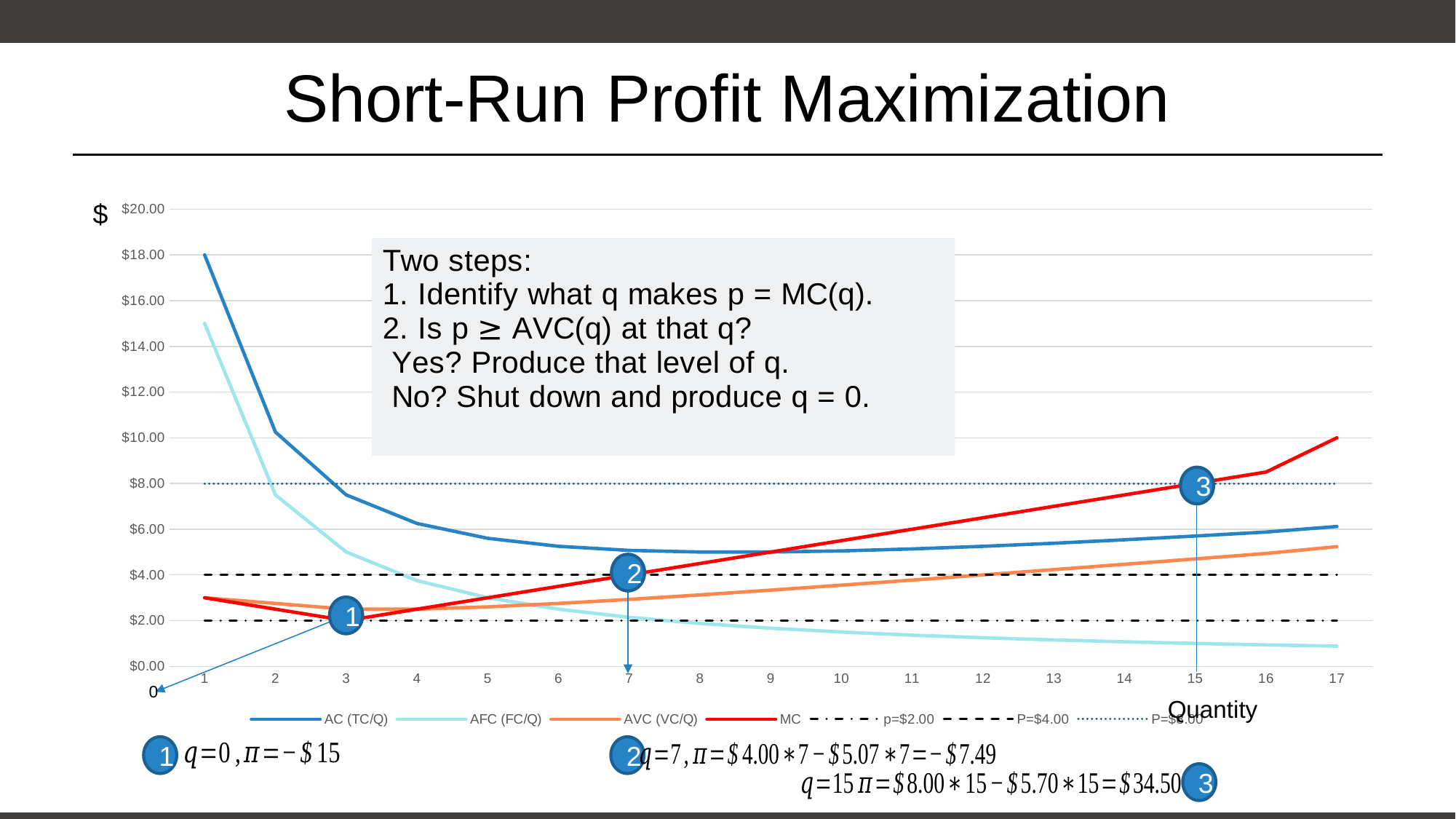
At quantity 17, which is higher: AC (TC/Q) or AVC (VC/Q)? AC (TC/Q) Which series has the highest value at quantity 1? AC (TC/Q) How many series does the chart legend list? 7 Is the value of AFC (FC/Q) at quantity 17 greater or less than $2.00? less Which series has the lowest value at quantity 17? AFC (FC/Q) Is the value of AC (TC/Q) at quantity 1 greater or less than $16.00? greater What kind of chart is shown on the slide? line chart What is the label on the x axis of the chart? Quantity How many quantity values are marked along the x axis of the chart? 17 Is the value of MC at quantity 17 greater or less than $8.00? greater Does the AFC (FC/Q) line rise or fall as quantity increases? fall Does the MC line rise or fall as quantity increases from 3 to 17? rise